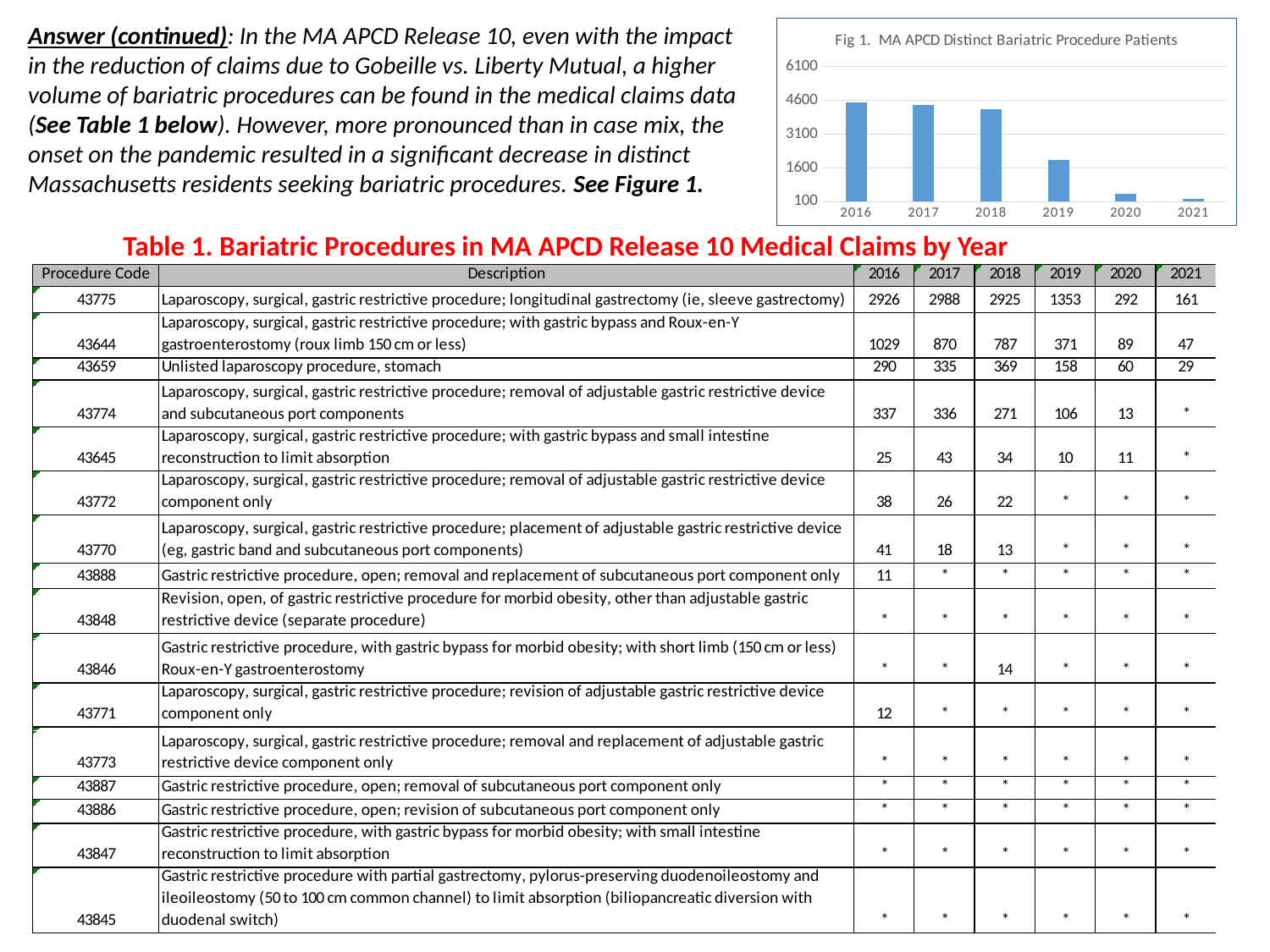
How many years are shown on the x axis of the Fig 1 chart? 6 In the Fig 1 chart, which year has the lowest number of distinct bariatric procedure patients? 2021 In the Fig 1 chart, which year has the larger value, 2018 or 2019? 2018 In the Fig 1 chart, which year has the larger value, 2020 or 2016? 2016 In the Fig 1 chart, do the values generally rise or fall from 2016 to 2021? fall What kind of chart is Fig 1. MA APCD Distinct Bariatric Procedure Patients? bar chart In the Fig 1 chart, is the value for 2018 greater or less than 3100? greater In the Fig 1 chart, is the value for 2019 greater or less than 3100? less In the Fig 1 chart, is the value for 2016 greater or less than 3100? greater What is the title of the chart on the slide? Fig 1. MA APCD Distinct Bariatric Procedure Patients